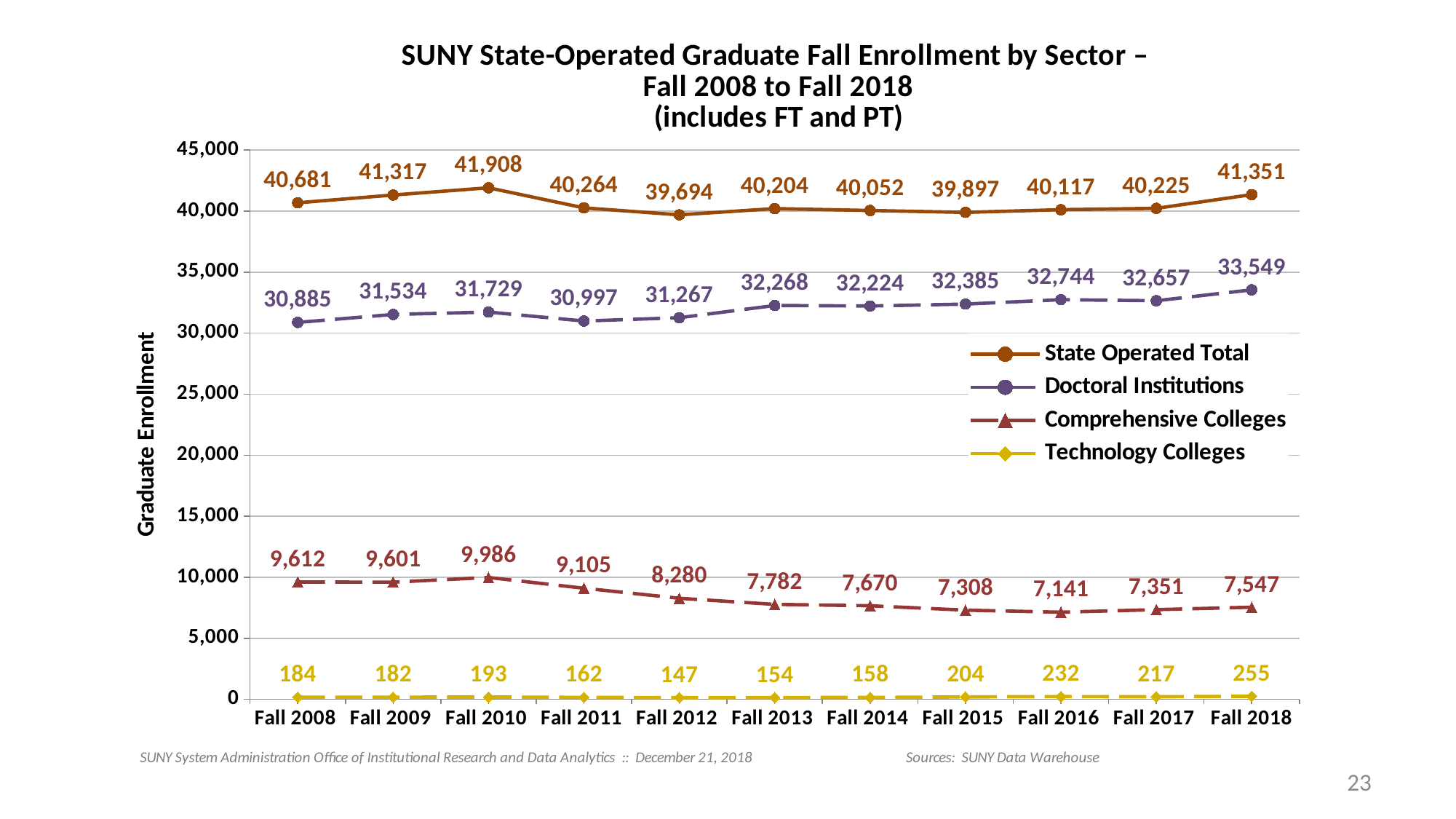
Did the Comprehensive Colleges enrollment rise or fall from Fall 2010 to Fall 2016? Fall In which fall term was the State Operated Total graduate enrollment highest? Fall 2010 Which was larger, the Comprehensive Colleges enrollment in Fall 2010 or in Fall 2016? Fall 2010 In which fall term was the Technology Colleges graduate enrollment lowest? Fall 2012 What kind of chart is shown on the slide? Line chart What was the Technology Colleges graduate enrollment in Fall 2015? 204 What is the difference between the Doctoral Institutions enrollment in Fall 2018 and Fall 2008? 2,664 How many series does the legend list? 4 What was the Doctoral Institutions graduate enrollment in Fall 2018? 33,549 What was the State Operated Total graduate enrollment in Fall 2010? 41,908 How many fall terms are shown on the x axis? 11 What was the Comprehensive Colleges graduate enrollment in Fall 2012? 8,280